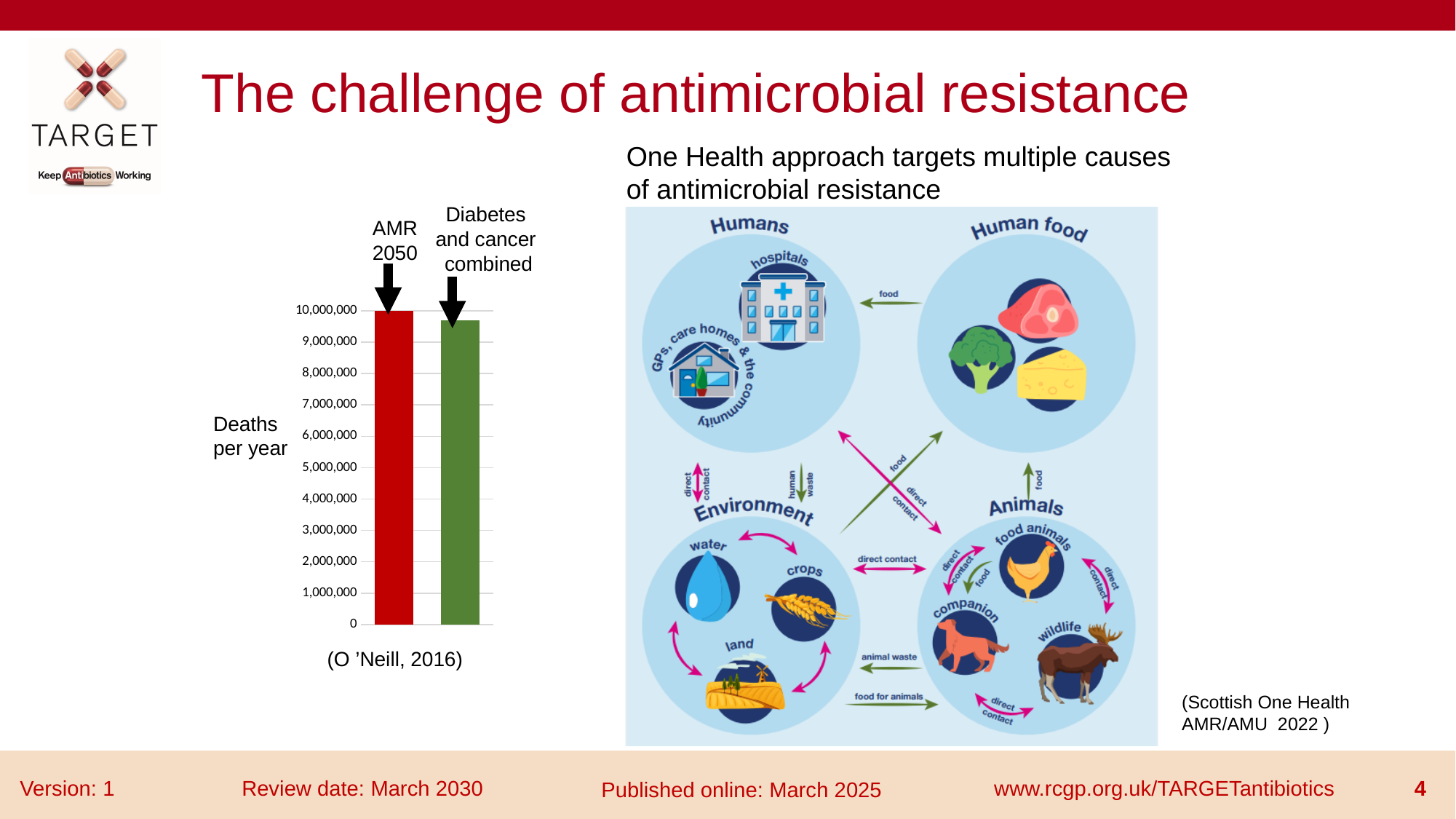
What source is cited beneath the chart? (O 'Neill, 2016) What is the label on the vertical axis of the chart? Deaths per year Is the value for diabetes and cancer combined greater or less than 10,000,000? less How many bars are plotted in the chart? 2 What kind of chart is shown on the slide? bar chart Which category has the lowest deaths per year? Diabetes and cancer combined Is the value for diabetes and cancer combined greater or less than 9,000,000? greater What is the value of deaths per year for AMR 2050? 10,000,000 Which category has the highest deaths per year? AMR 2050 Which is larger, deaths per year for AMR 2050 or for diabetes and cancer combined? AMR 2050